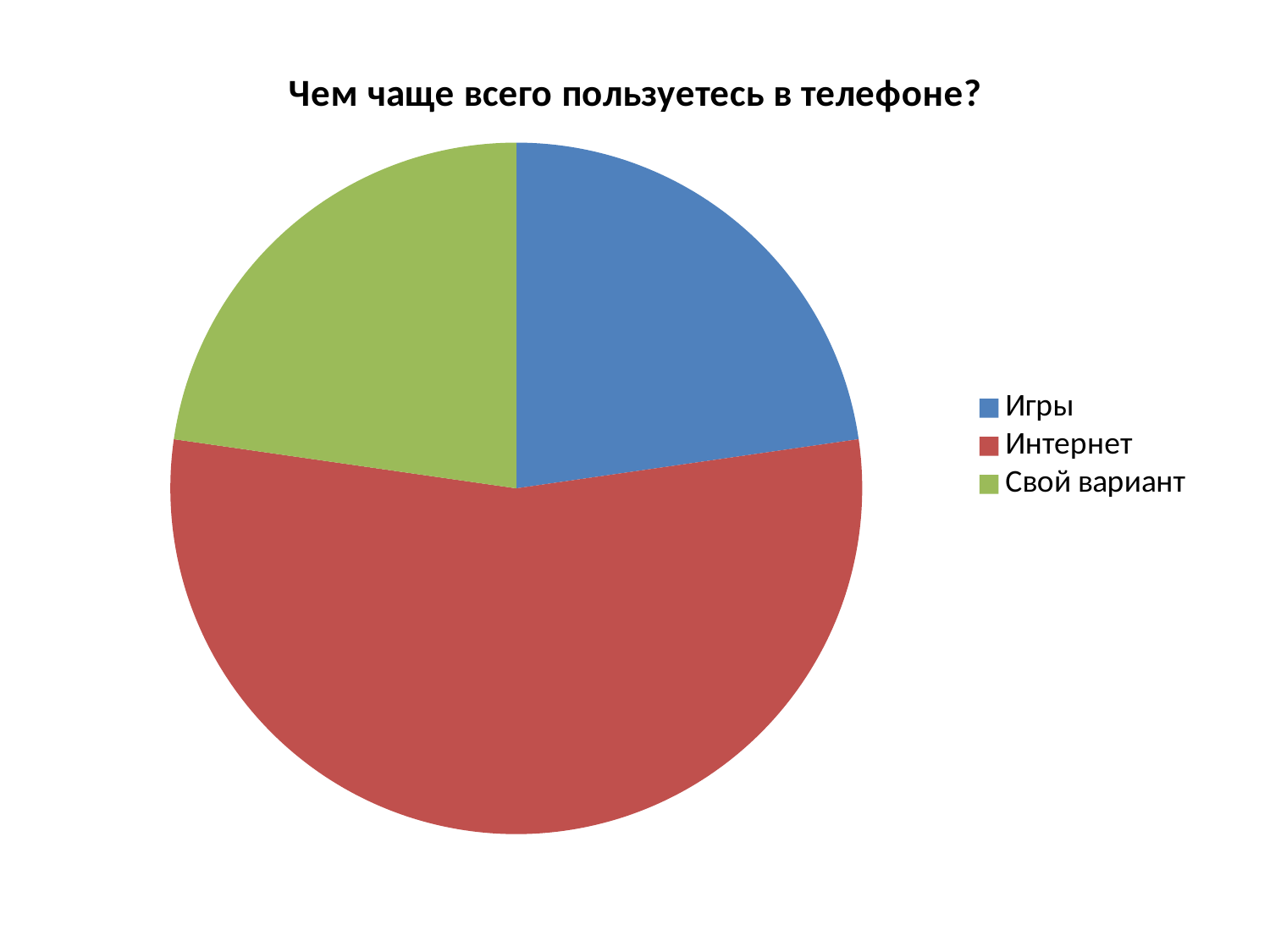
How many entries does the legend list? 3 How many slices does the pie chart have? 3 What is the title of the chart? Чем чаще всего пользуетесь в телефоне? Which slice is larger, Интернет or Свой вариант? Интернет What kind of chart is shown on the slide? pie chart Which slice is larger, Интернет or Игры? Интернет Which colour represents Свой вариант in the pie chart? green Which category has the largest slice of the pie? Интернет